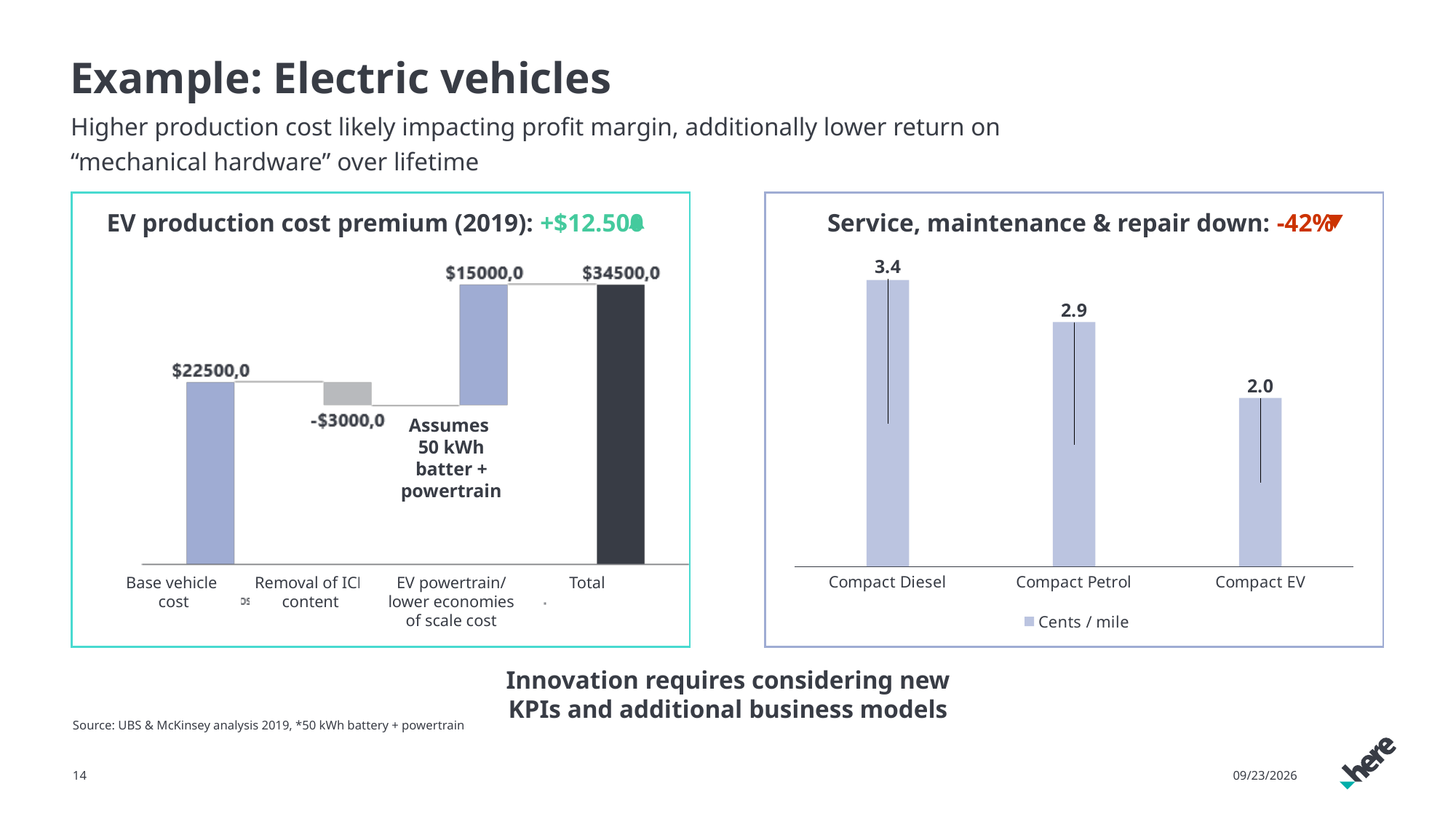
In the 'EV production cost premium (2019)' chart, what is the value for Total? $34500,0 In the 'Service, maintenance & repair down' chart, what is the value for Compact EV? 2.0 In the 'EV production cost premium (2019)' chart, which is larger: Base vehicle cost or EV powertrain/lower economies of scale cost? Base vehicle cost In the 'Service, maintenance & repair down' chart, do the values rise or fall from Compact Diesel to Compact EV? fall In the 'Service, maintenance & repair down' chart, which category has the highest value? Compact Diesel In the 'Service, maintenance & repair down' chart, what is the value for Compact Diesel? 3.4 In the 'Service, maintenance & repair down' chart, what series does the legend list? Cents / mile In the 'Service, maintenance & repair down' chart, how many categories are shown? 3 In the 'EV production cost premium (2019)' chart, what is the value for Removal of ICE content? -$3000,0 In the 'Service, maintenance & repair down' chart, what is the difference between Compact Diesel and Compact EV? 1.4 In the 'Service, maintenance & repair down' chart, which category has the lowest value? Compact EV In the 'EV production cost premium (2019)' chart, what is the value for Base vehicle cost? $22500,0